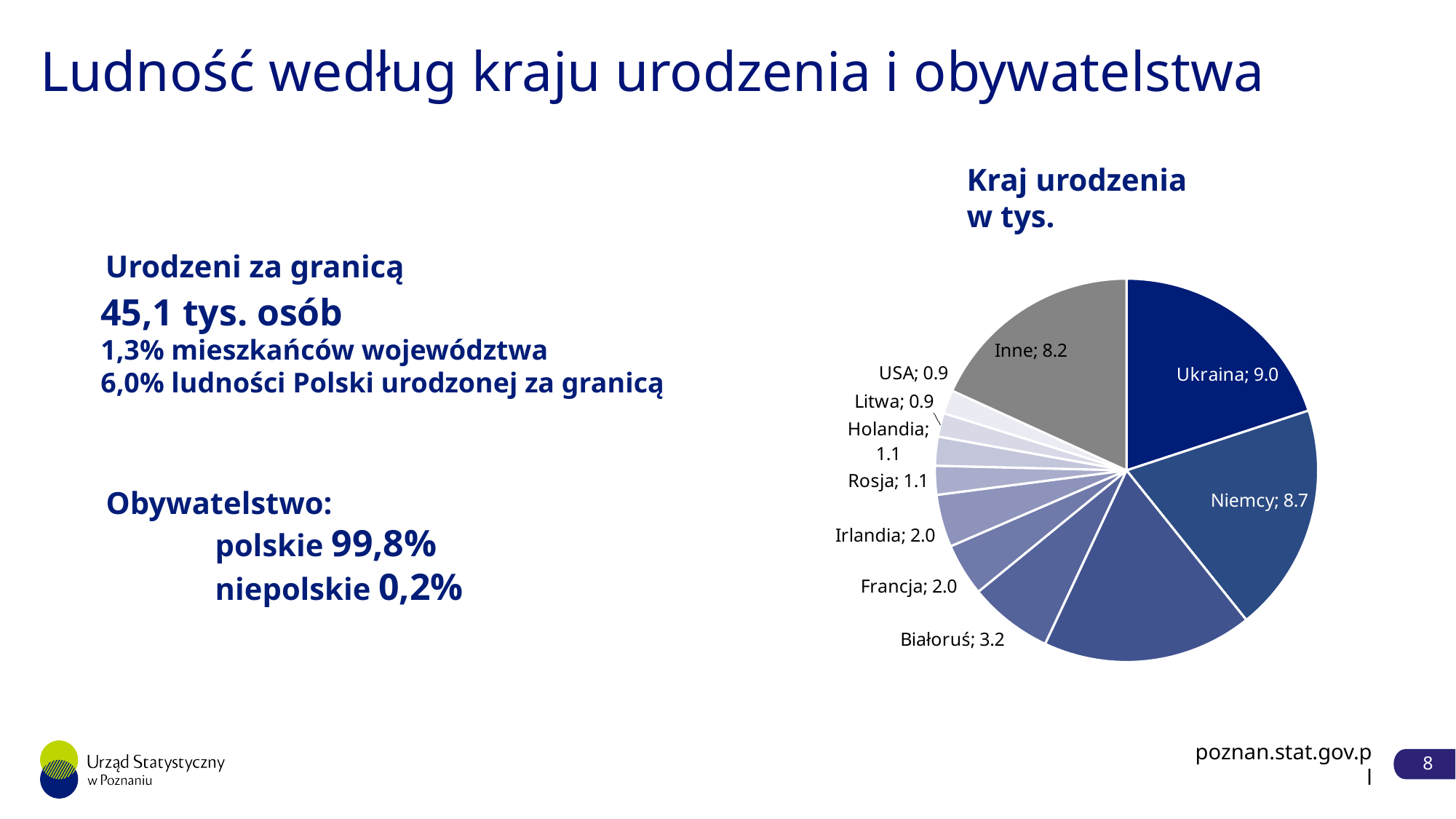
What is the difference between the values for Ukraina and Niemcy? 0.3 What is the value for Niemcy in the pie chart? 8.7 Which category has the largest slice in the pie chart? Ukraina How many slices does the pie chart have? 11 What kind of chart is shown on the slide? Pie chart Which two categories share the smallest value in the pie chart? Litwa and USA What is the difference between the values for Inne and Białoruś? 5.0 What is the title of the chart? Kraj urodzenia w tys. What is the value for Ukraina in the pie chart? 9.0 What is the value for Białoruś in the pie chart? 3.2 Which is larger, the value for Niemcy or the value for Inne? Niemcy What is the value for Holandia in the pie chart? 1.1